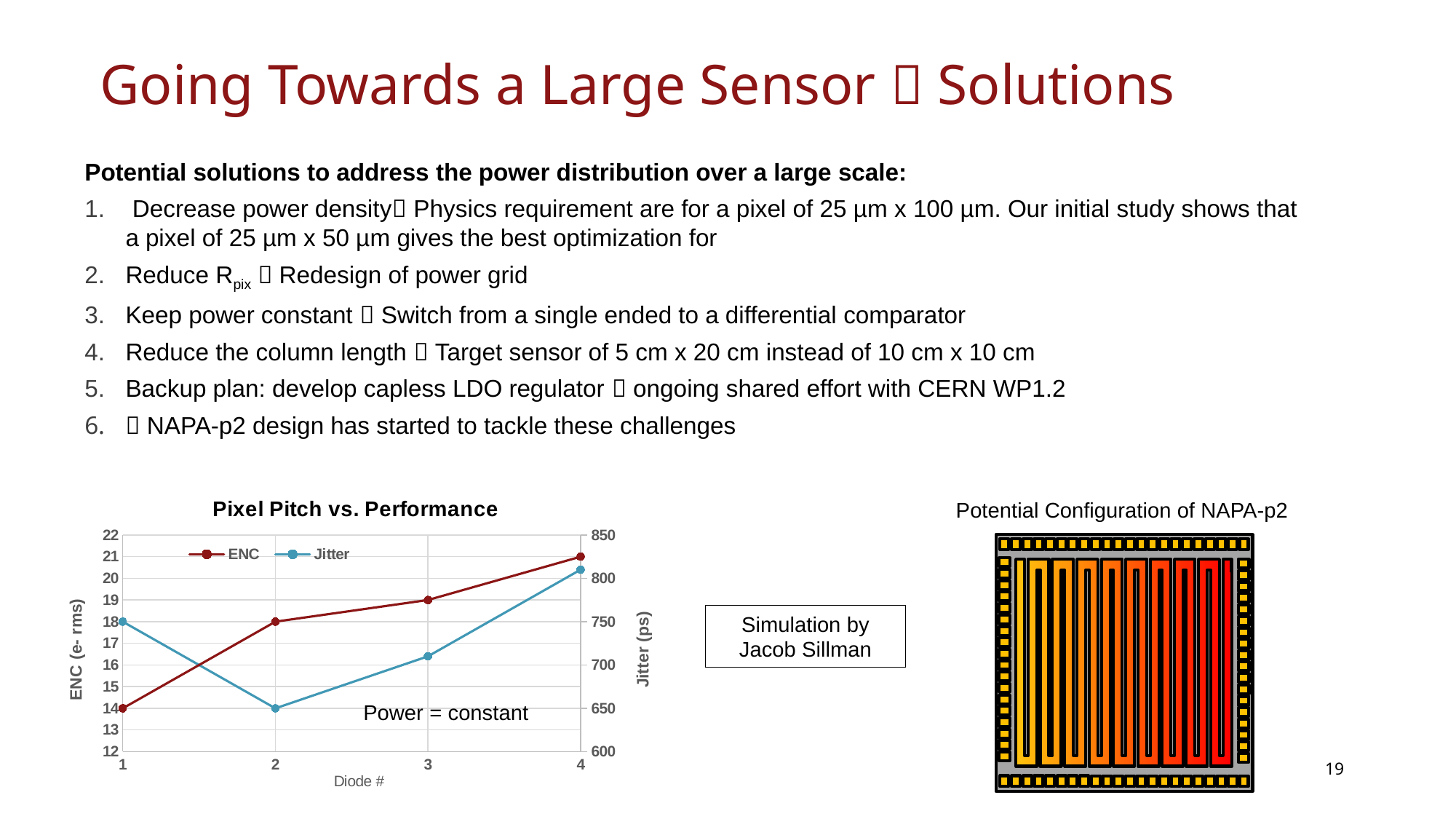
In the 'Pixel Pitch vs. Performance' chart, does the ENC series rise or fall from Diode 1 to Diode 4? rise In the 'Pixel Pitch vs. Performance' chart, which diode has the lowest Jitter? Diode 2 How many series does the legend of the 'Pixel Pitch vs. Performance' chart list? 2 What is the label of the x axis of the 'Pixel Pitch vs. Performance' chart? Diode # In the 'Pixel Pitch vs. Performance' chart, what is the ENC value for Diode 1? 14 In the 'Pixel Pitch vs. Performance' chart, which is larger, the ENC for Diode 1 or the ENC for Diode 2? Diode 2 In the 'Pixel Pitch vs. Performance' chart, is the Jitter value for Diode 3 greater or less than 750? less In the 'Pixel Pitch vs. Performance' chart, what is the Jitter value for Diode 1? 750 How many diode points are plotted along the x axis of the 'Pixel Pitch vs. Performance' chart? 4 In the 'Pixel Pitch vs. Performance' chart, which diode has the highest ENC? Diode 4 What type of chart is 'Pixel Pitch vs. Performance'? line chart In the 'Pixel Pitch vs. Performance' chart, what is the Jitter value for Diode 2? 650